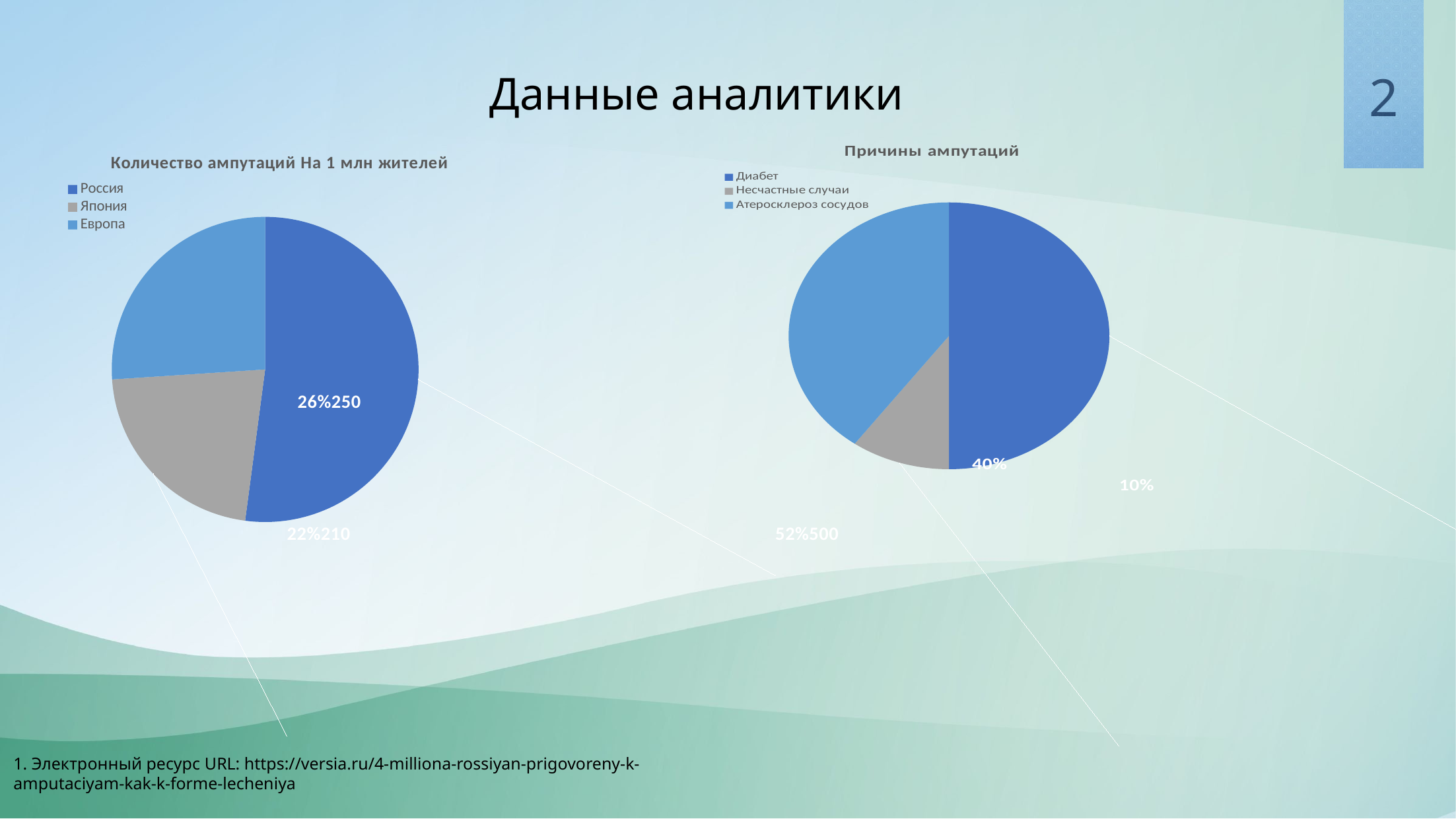
What is the title of the pie chart on the right side of the slide? Причины ампутаций In the chart "Количество ампутаций На 1 млн жителей", which category has the largest slice? Россия In the chart "Причины ампутаций", which cause has the largest slice? Диабет In the chart "Количество ампутаций На 1 млн жителей", which slice is larger: Россия or Европа? Россия In the chart "Причины ампутаций", which slice is larger: Атеросклероз сосудов or Несчастные случаи? Атеросклероз сосудов In the chart "Количество ампутаций На 1 млн жителей", how many entries does the legend list? 3 In the chart "Количество ампутаций На 1 млн жителей", how many slices does the pie have? 3 What kind of chart is the chart titled "Количество ампутаций На 1 млн жителей"? pie chart In the chart "Количество ампутаций На 1 млн жителей", which category has the smallest slice? Япония In the chart "Причины ампутаций", which cause has the smallest slice? Несчастные случаи In the chart "Причины ампутаций", how many slices does the pie have? 3 What kind of chart is the chart titled "Причины ампутаций"? pie chart